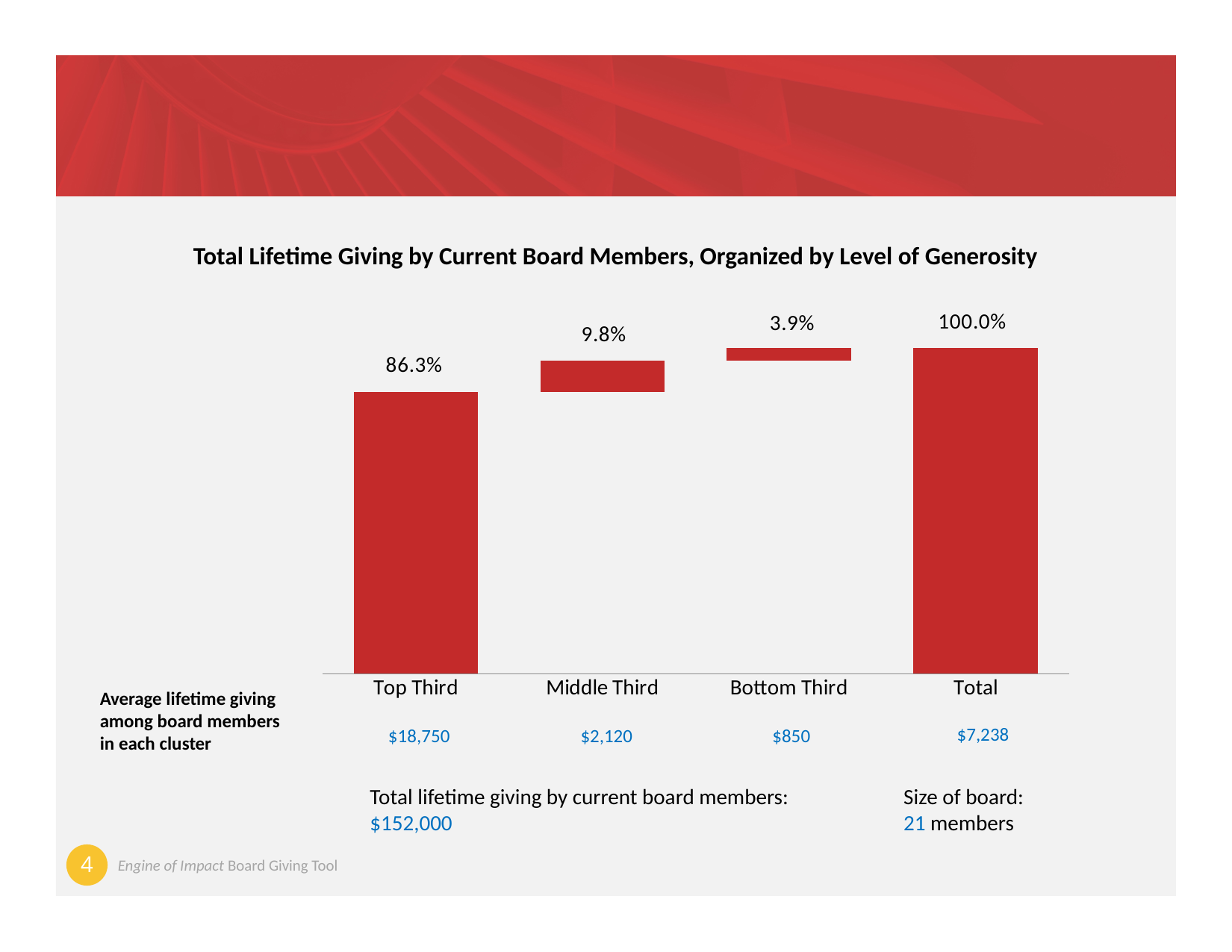
Which of the three clusters (Top, Middle, Bottom Third) has the highest share of total lifetime giving? Top Third Which has a larger share of giving, the Middle Third or the Bottom Third? Middle Third What kind of chart is shown on the slide? Bar chart What percentage is shown for the Middle Third? 9.8% Which of the three clusters has the lowest share of total lifetime giving? Bottom Third How many bars are plotted in the chart? 4 What is the difference in percentage points between the Top Third and the Middle Third? 76.5 What is the difference in percentage points between the Middle Third and the Bottom Third? 5.9 What percentage is shown for the Total bar? 100.0% What percentage of total lifetime giving is shown for the Top Third? 86.3% What is the title of the chart? Total Lifetime Giving by Current Board Members, Organized by Level of Generosity What percentage is shown for the Bottom Third? 3.9%